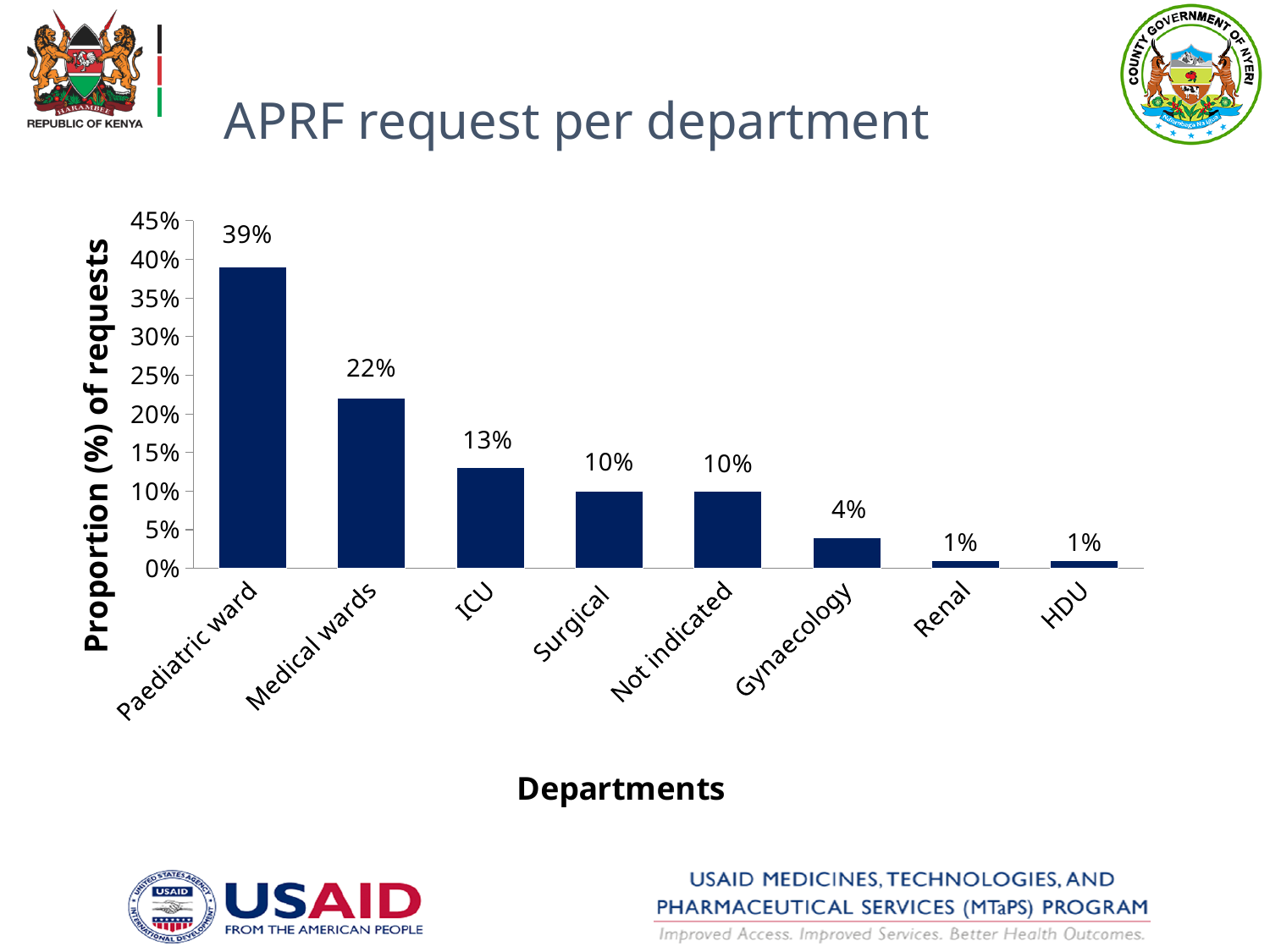
What kind of chart is shown on the slide? Bar chart Which department has the highest proportion of APRF requests? Paediatric ward What is the difference in proportion of requests between the Paediatric ward and Medical wards? 17% Do the values rise or fall moving from left to right along the x axis? Fall How many departments are shown on the x axis of the chart? 8 What proportion of APRF requests came from Gynaecology? 4% Is the value for Medical wards greater or less than 20%? greater What is the title of the chart? APRF request per department What proportion of APRF requests came from the Paediatric ward? 39% What is the label of the y axis? Proportion (%) of requests What proportion of APRF requests came from the ICU? 13% Which has a larger proportion of requests, ICU or Surgical? ICU